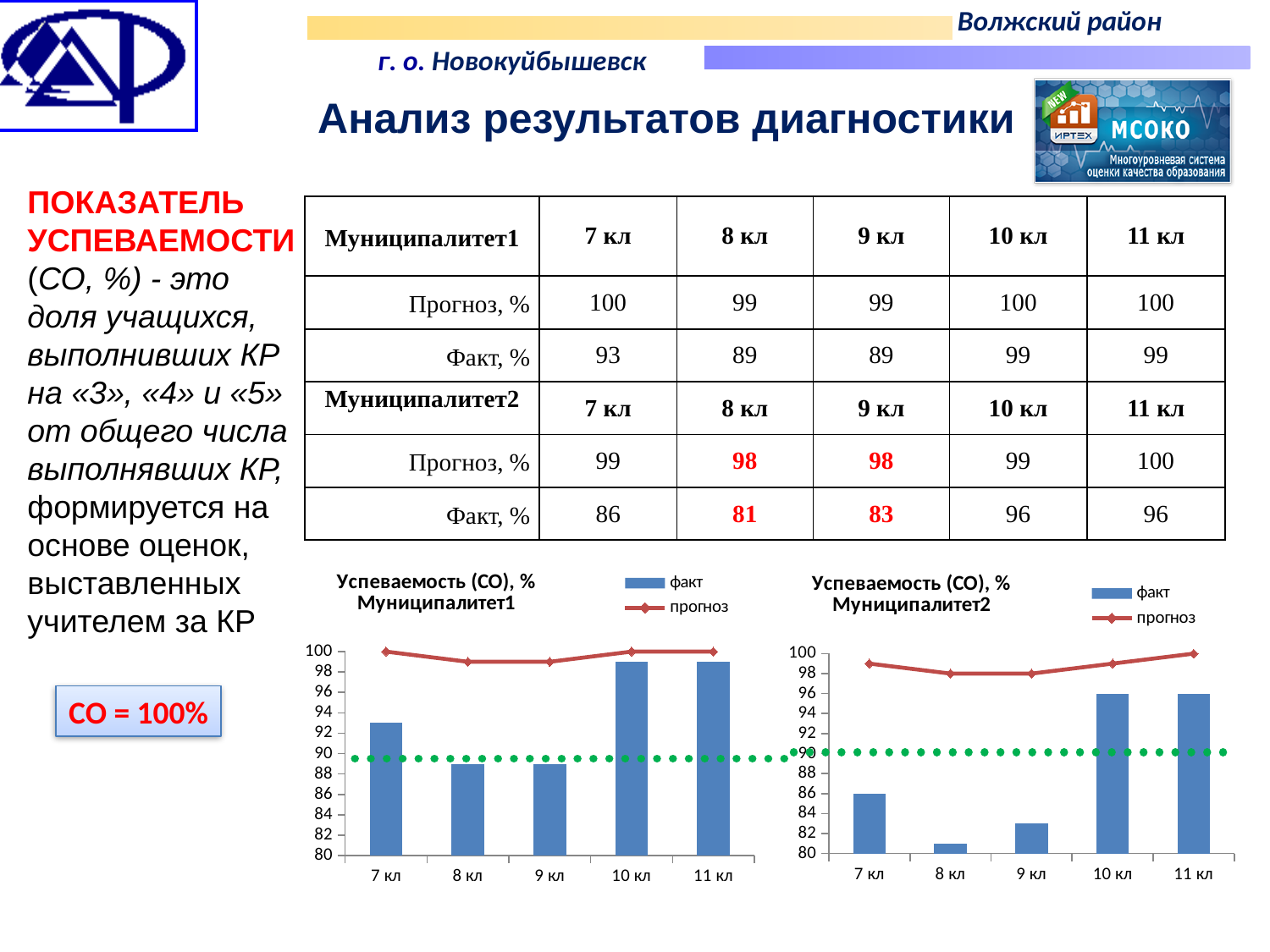
In the 'Успеваемость (СО), % Муниципалитет2' chart, is the факт value for 9 кл greater or less than 90? less How many categories are shown on the x axis of the 'Успеваемость (СО), % Муниципалитет1' chart? 5 In the 'Успеваемость (СО), % Муниципалитет2' chart, what is the прогноз value for 8 кл? 98 What kind of chart is the 'Успеваемость (СО), % Муниципалитет1' chart? bar chart with a line series What are the two legend entries of the 'Успеваемость (СО), % Муниципалитет1' chart? факт and прогноз In the 'Успеваемость (СО), % Муниципалитет2' chart, what is the факт value for 7 кл? 86 In the 'Успеваемость (СО), % Муниципалитет2' chart, which category has the lowest факт bar? 8 кл How many series does the legend of the 'Успеваемость (СО), % Муниципалитет2' chart list? 2 In the 'Успеваемость (СО), % Муниципалитет2' chart, what is the difference between the прогноз and факт values for 11 кл? 4 In the 'Успеваемость (СО), % Муниципалитет1' chart, which факт bar is taller: 7 кл or 8 кл? 7 кл In the 'Успеваемость (СО), % Муниципалитет1' chart, is the факт value for 7 кл greater or less than 90? greater In the 'Успеваемость (СО), % Муниципалитет1' chart, what is the факт value for 7 кл? 93